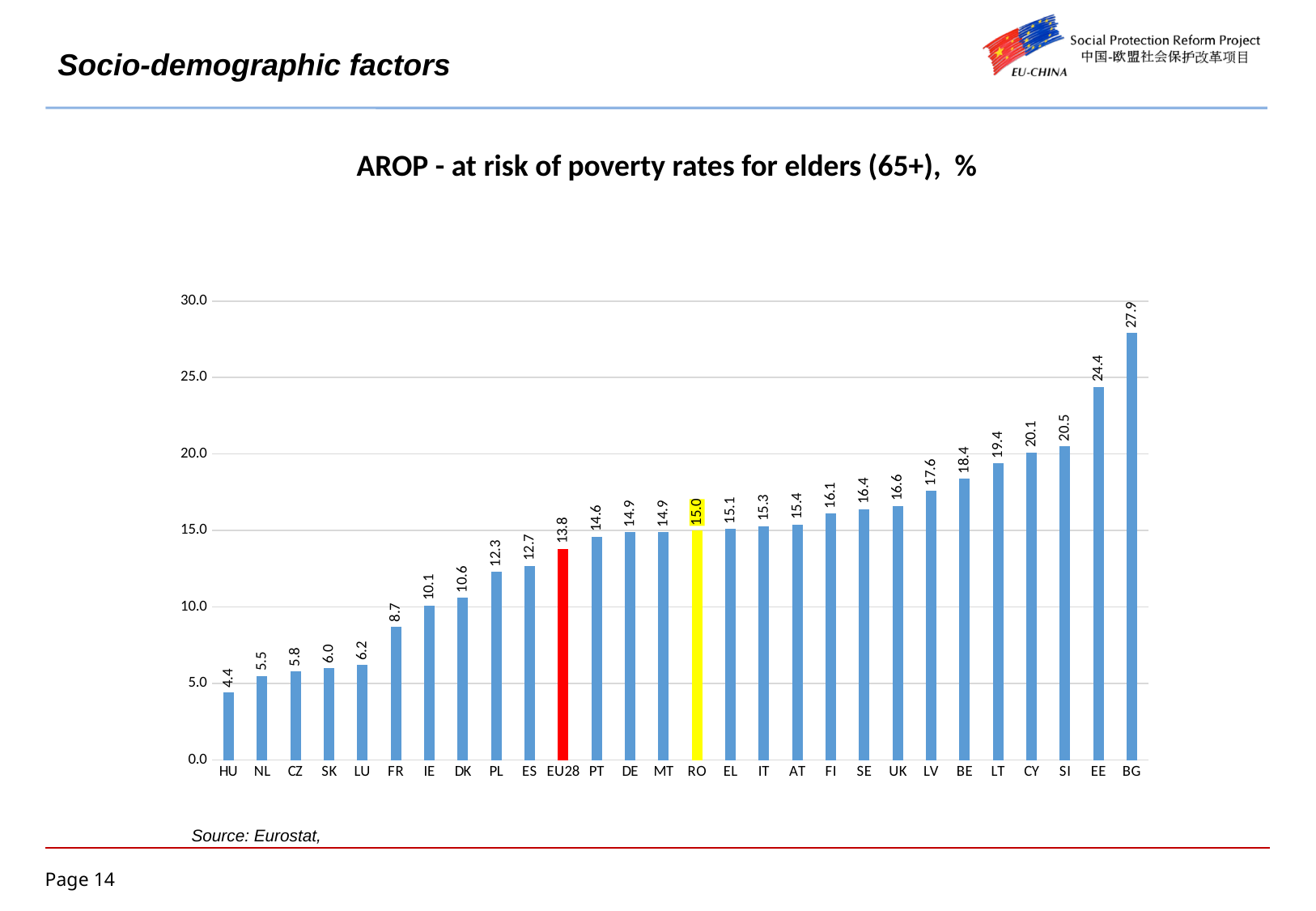
Which country has the lowest AROP rate? HU Which has a higher AROP rate, SE or PL? SE What is the AROP rate for RO? 15.0 What type of chart is shown? Bar chart Which bar is highlighted in yellow? RO How many bars are shown in the chart? 28 What is the difference between the AROP rates of BG and HU? 23.5 Which country has the highest AROP rate? BG What is the AROP rate for FR? 8.7 Do the values rise or fall from left to right along the x axis? Rise What is the AROP rate for EU28? 13.8 What is the difference between the AROP rates of RO and EU28? 1.2